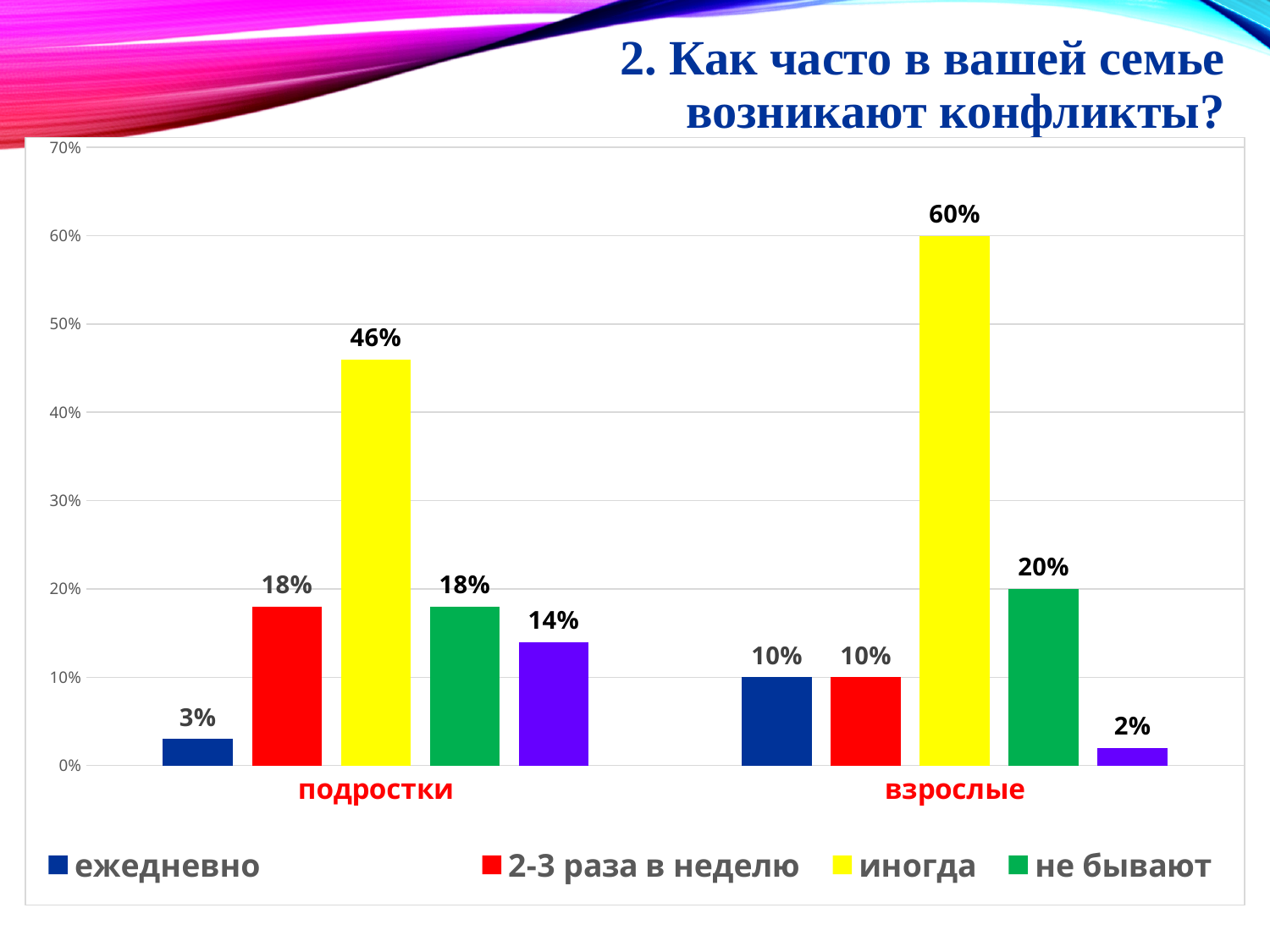
What is the value for "ежедневно" in the "подростки" category? 3% What is the value for "2-3 раза в неделю" in the "взрослые" category? 10% What is the difference between the "иногда" values for "взрослые" and "подростки"? 14% What is the value for "не бывают" in the "взрослые" category? 20% How many series does the legend list? 4 What colour are the bars for the "иногда" series? yellow Which series has the highest value in the "взрослые" category? иногда Which series has the lowest value in the "подростки" category? ежедневно What is the value for "иногда" in the "взрослые" category? 60% What kind of chart is shown on the slide? bar chart Which is larger: "ежедневно" for "подростки" or "ежедневно" for "взрослые"? взрослые What is the value for "иногда" in the "подростки" category? 46%